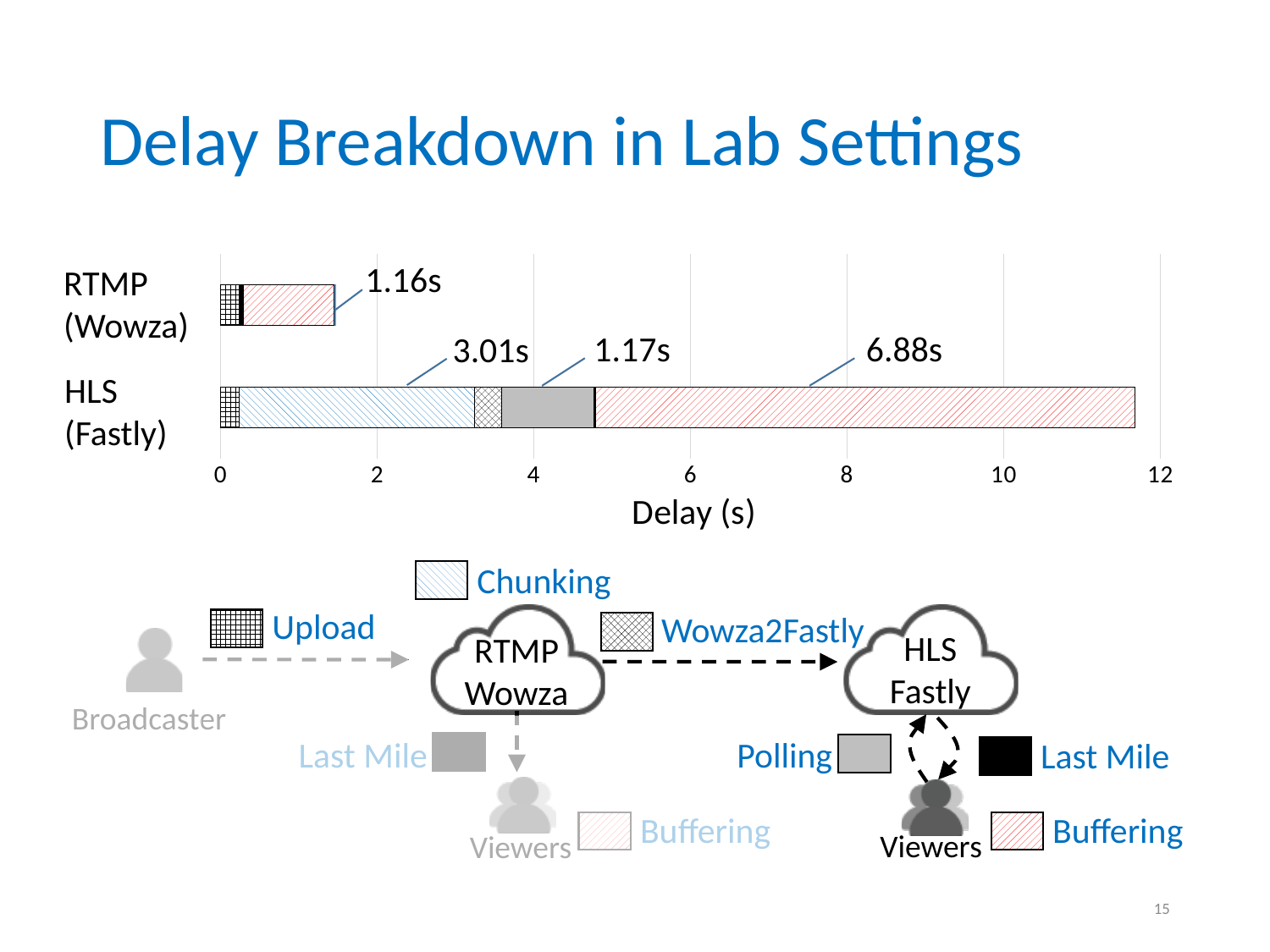
What kind of chart is shown on the slide? bar chart How many categories (streaming setups) are plotted in the chart? 2 What is the labelled Buffering delay for HLS (Fastly)? 6.88s What is the labelled Polling delay for HLS (Fastly)? 1.17s What is the title of the x axis? Delay (s) Which setup has the longest total delay? HLS (Fastly) Is the total delay for RTMP (Wowza) greater or less than 2? less Which setup has the larger Buffering delay, RTMP (Wowza) or HLS (Fastly)? HLS (Fastly) What is the difference between the Buffering delay of HLS (Fastly) and that of RTMP (Wowza)? 5.72s Is the total delay for HLS (Fastly) greater or less than 10? greater What is the labelled Buffering delay for RTMP (Wowza)? 1.16s What is the labelled Chunking delay for HLS (Fastly)? 3.01s